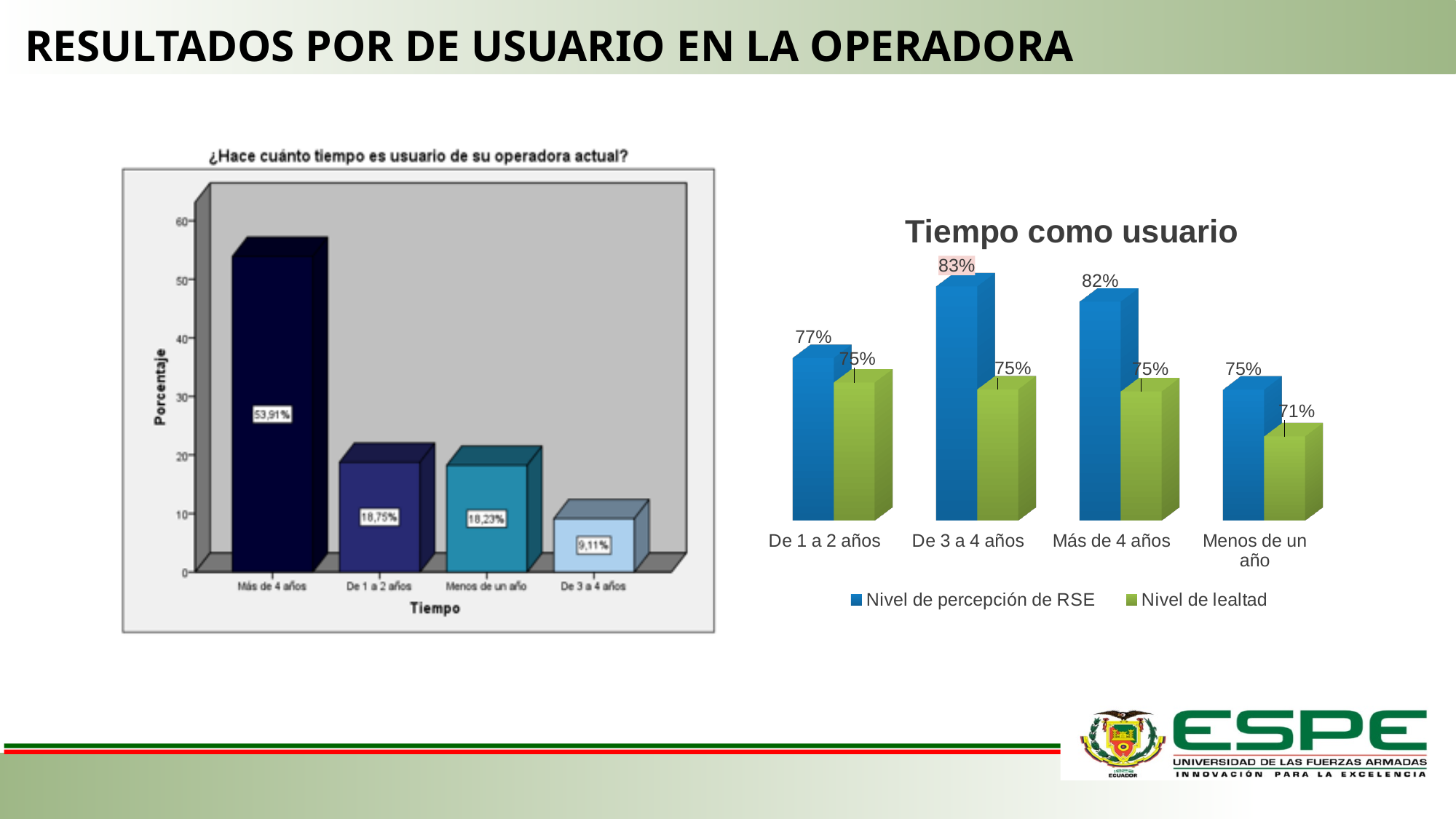
In the right chart 'Tiempo como usuario', which category has the highest 'Nivel de percepción de RSE'? De 3 a 4 años In the left chart '¿Hace cuánto tiempo es usuario de su operadora actual?', which category has the highest percentage? Más de 4 años In the left chart '¿Hace cuánto tiempo es usuario de su operadora actual?', what is the value for 'Más de 4 años'? 53,91% In the right chart 'Tiempo como usuario', how many series does the legend list? 2 In the left chart '¿Hace cuánto tiempo es usuario de su operadora actual?', how many categories are shown on the x axis? 4 In the left chart '¿Hace cuánto tiempo es usuario de su operadora actual?', what is the value for 'De 3 a 4 años'? 9,11% What kind of chart is the right chart 'Tiempo como usuario'? Bar chart In the right chart 'Tiempo como usuario', what is the difference between 'Nivel de percepción de RSE' and 'Nivel de lealtad' for 'Más de 4 años'? 7% In the left chart '¿Hace cuánto tiempo es usuario de su operadora actual?', what is the difference between 'De 1 a 2 años' and 'Menos de un año'? 0,52% In the right chart 'Tiempo como usuario', what is the 'Nivel de lealtad' value for 'Menos de un año'? 71% In the left chart '¿Hace cuánto tiempo es usuario de su operadora actual?', which category has the lowest percentage? De 3 a 4 años In the right chart 'Tiempo como usuario', what is the 'Nivel de percepción de RSE' value for 'De 3 a 4 años'? 83%